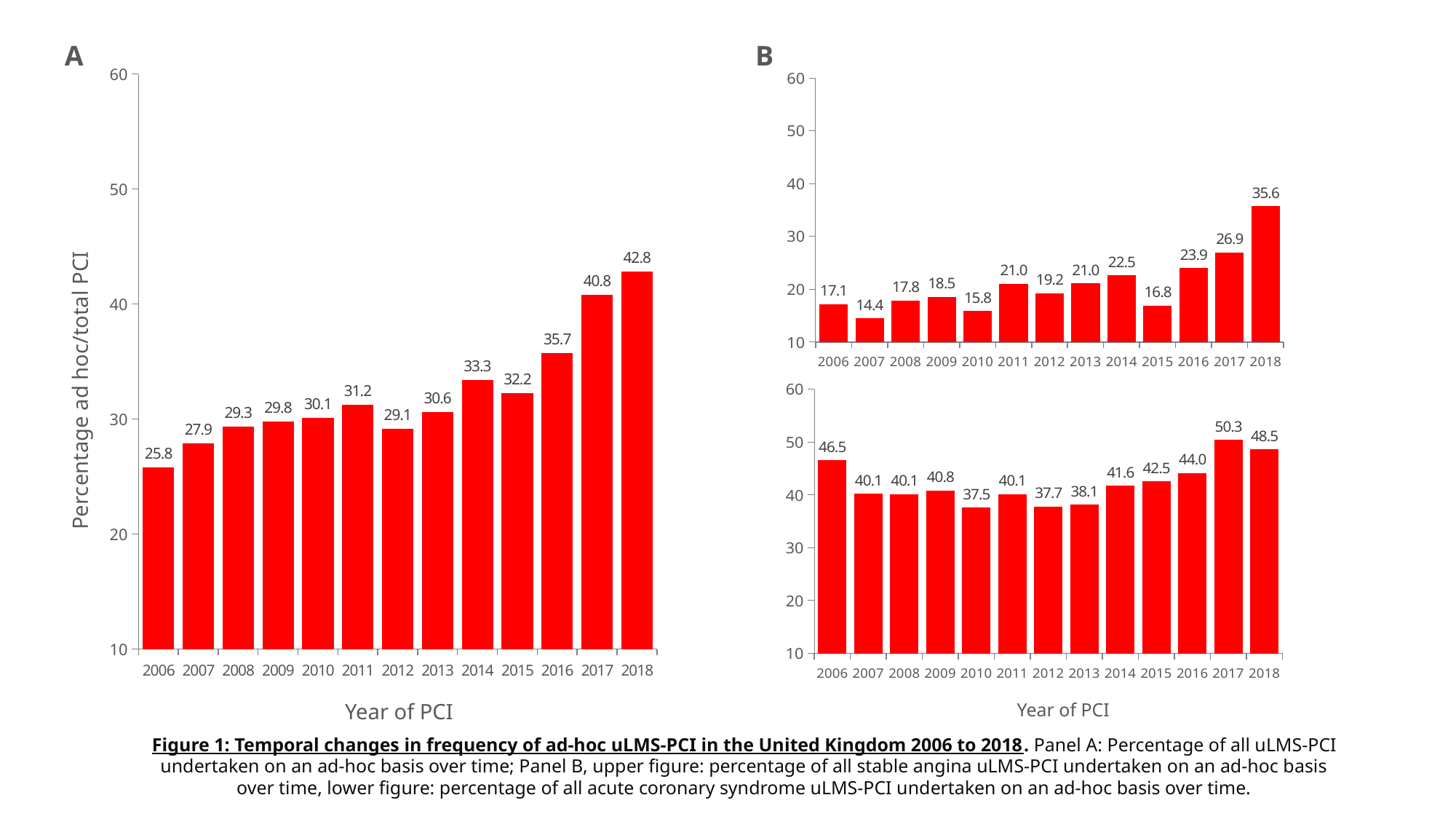
In Panel A, which year has the lowest value? 2006 In Panel B, lower figure, what is the value for 2017? 50.3 In Panel A, what is the value for 2018? 42.8 In Panel A, what is the difference between the values for 2018 and 2006? 17.0 In Panel B, lower figure, which year has the lowest value? 2010 In Panel B, lower figure, is the value for 2006 larger than the value for 2016? Yes In Panel B, upper figure, which year has the lowest value? 2007 In Panel A, how many years are plotted on the x axis? 13 In Panel A, what type of chart is shown? bar chart In Panel B, upper figure, what is the value for 2015? 16.8 In Panel A, what is the label of the y axis? Percentage ad hoc/total PCI In Panel B, upper figure, which year has the highest value? 2018